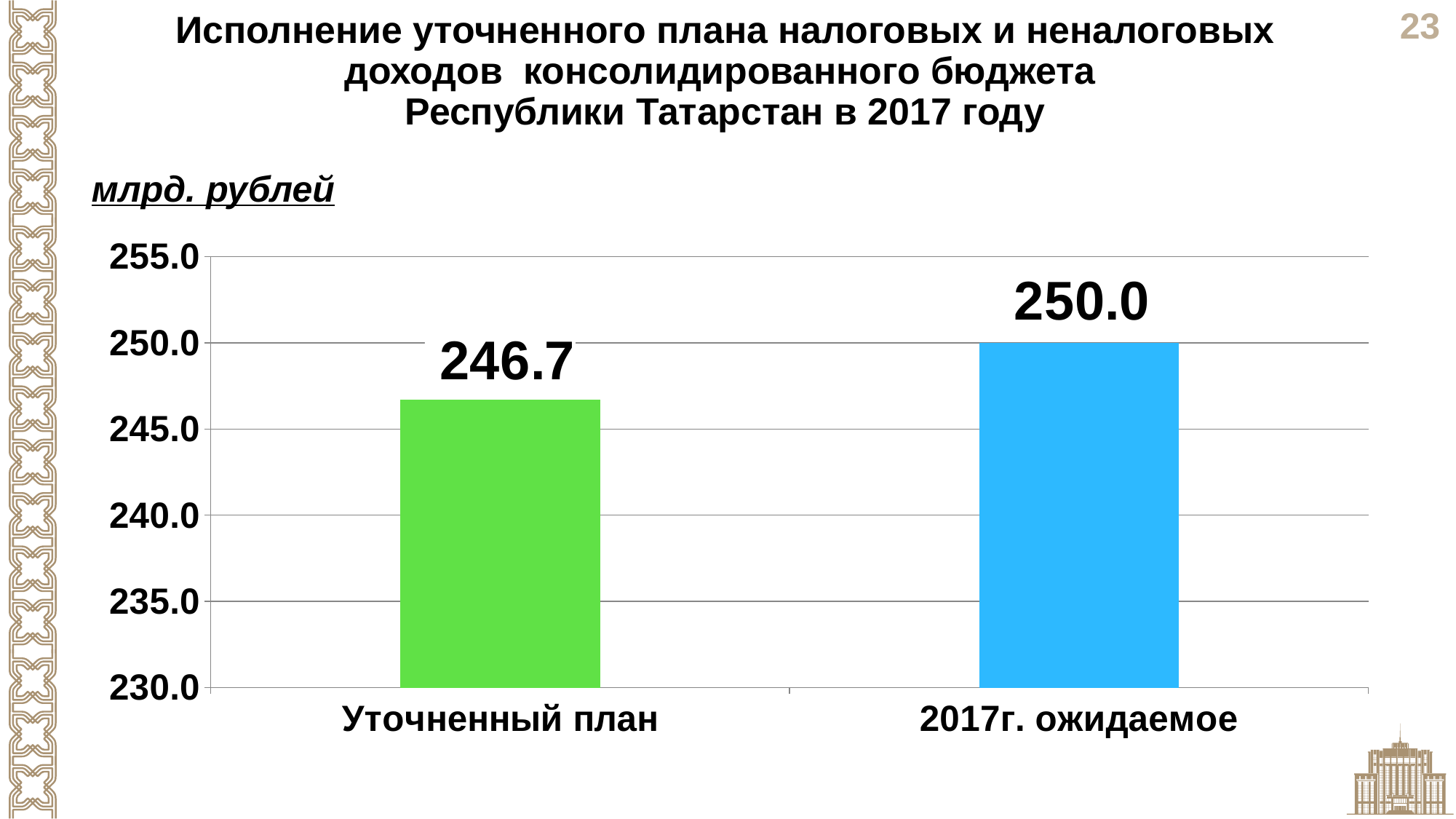
What colour is the bar for "2017г. ожидаемое"? blue Is the value for "Уточненный план" greater or less than 245.0? greater Do the values rise or fall from left to right along the x axis? rise Which category has the lowest value? Уточненный план What is the difference between the value for "2017г. ожидаемое" and the value for "Уточненный план"? 3.3 How many categories are shown on the chart? 2 Which category has the highest value? 2017г. ожидаемое What unit of measurement is indicated above the chart? млрд. рублей Which is larger: the value for "Уточненный план" or the value for "2017г. ожидаемое"? 2017г. ожидаемое What kind of chart is shown on the slide? bar chart What is the value for "Уточненный план"? 246.7 What is the value for "2017г. ожидаемое"? 250.0